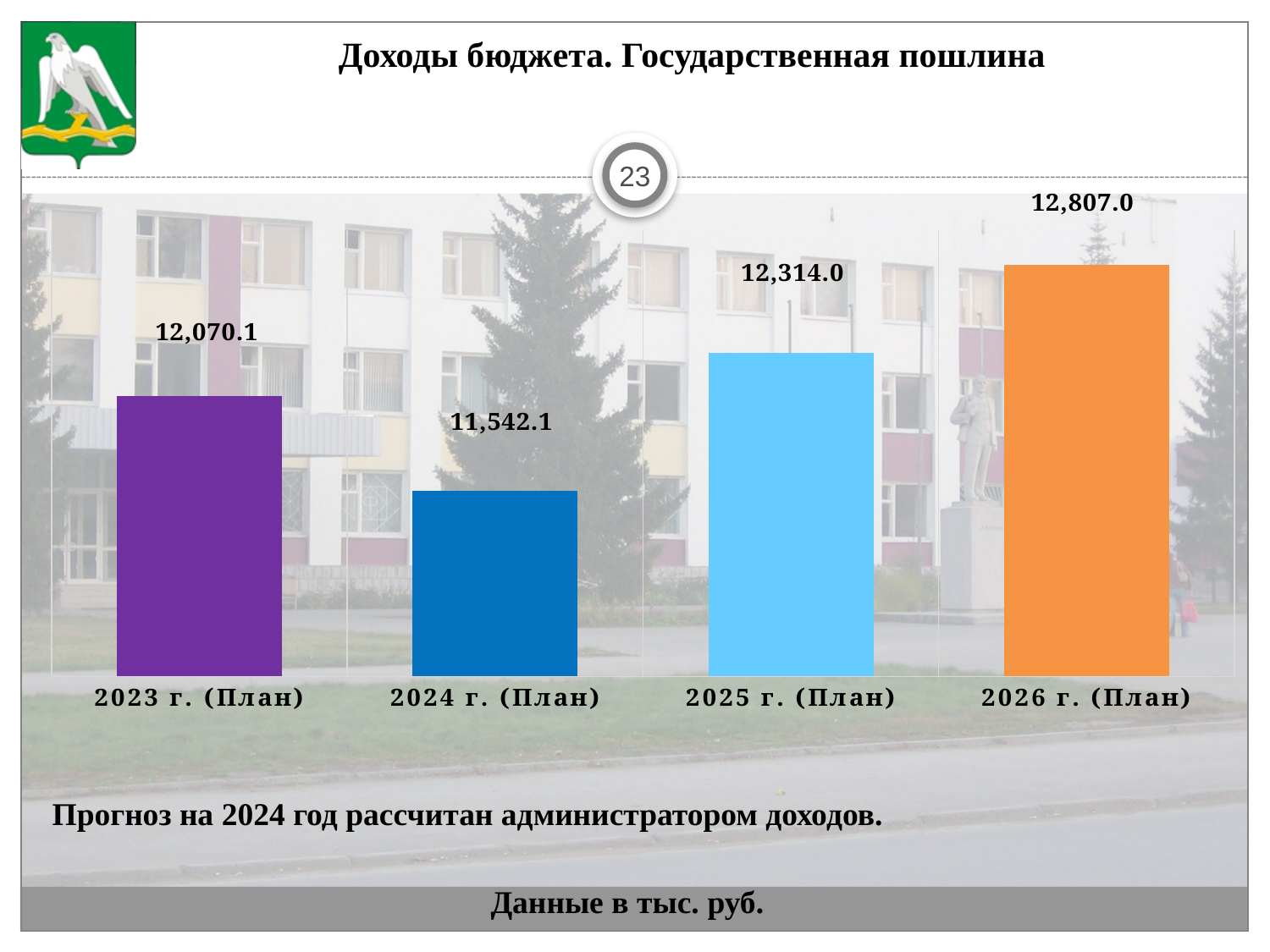
What is the value for 2024 г. (План)? 11,542.1 What is the difference between the values for 2023 г. (План) and 2024 г. (План)? 528.0 Which year has the highest value? 2026 г. (План) Which is larger, the value for 2023 г. (План) or 2025 г. (План)? 2025 г. (План) What is the value for 2023 г. (План)? 12,070.1 What is the value for 2026 г. (План)? 12,807.0 What is the difference between the values for 2026 г. (План) and 2025 г. (План)? 493.0 What kind of chart is shown on the slide? bar chart Do the values rise or fall from 2024 г. (План) to 2026 г. (План)? rise Which year has the lowest value? 2024 г. (План) How many bars are shown in the chart? 4 What is the value for 2025 г. (План)? 12,314.0